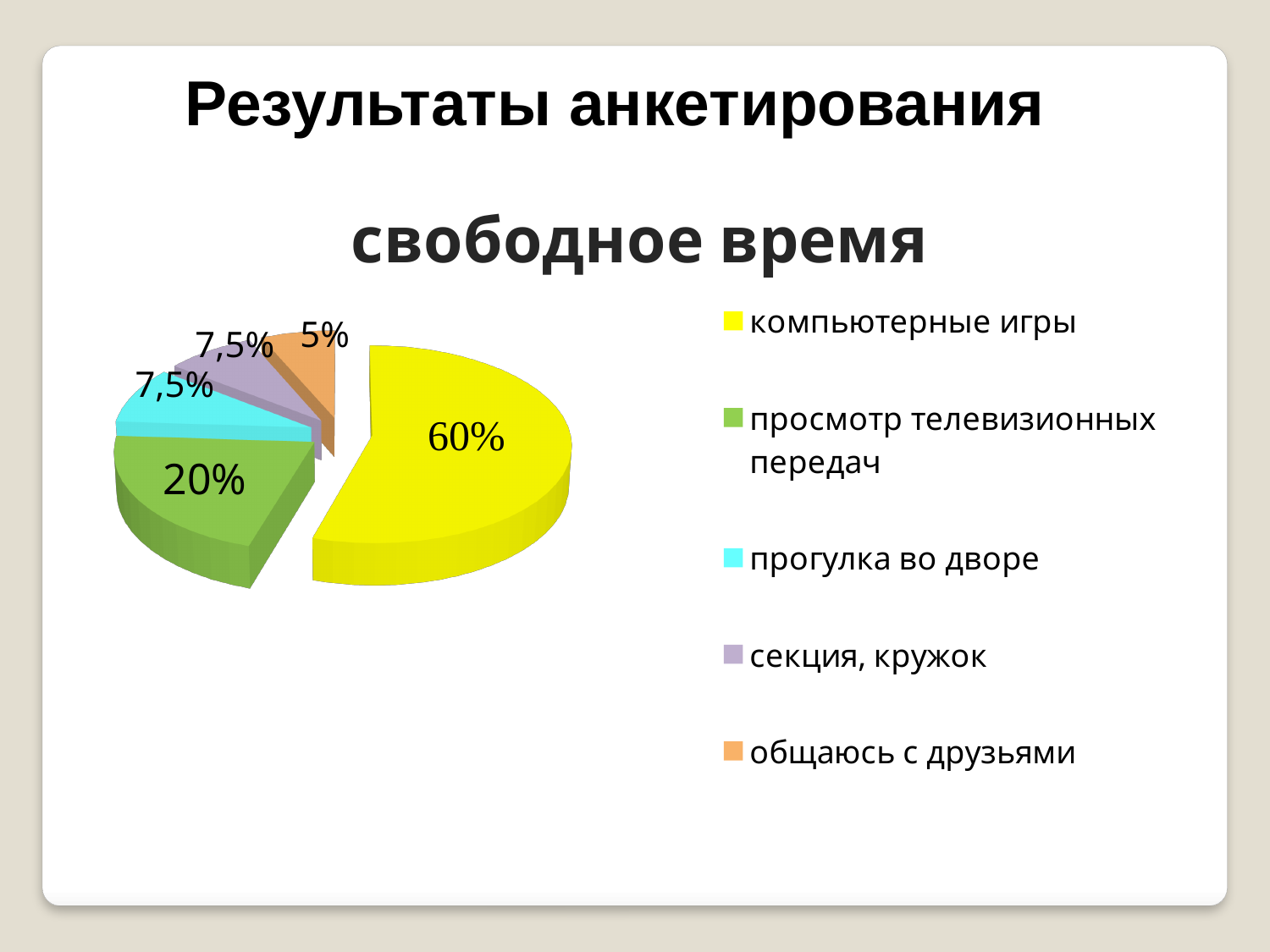
What share of the pie is labelled for общаюсь с друзьями? 5% What share of the pie is labelled for компьютерные игры? 60% Which category has the smallest slice of the pie? общаюсь с друзьями What kind of chart is shown on the slide? pie chart What is the title of the chart? свободное время What is the difference between the shares for компьютерные игры and просмотр телевизионных передач? 40% Which category has the largest slice of the pie? компьютерные игры What colour is the slice for прогулка во дворе? cyan What share of the pie is labelled for прогулка во дворе? 7,5% Which is larger: the share for секция, кружок or the share for общаюсь с друзьями? секция, кружок How many categories does the legend list? 5